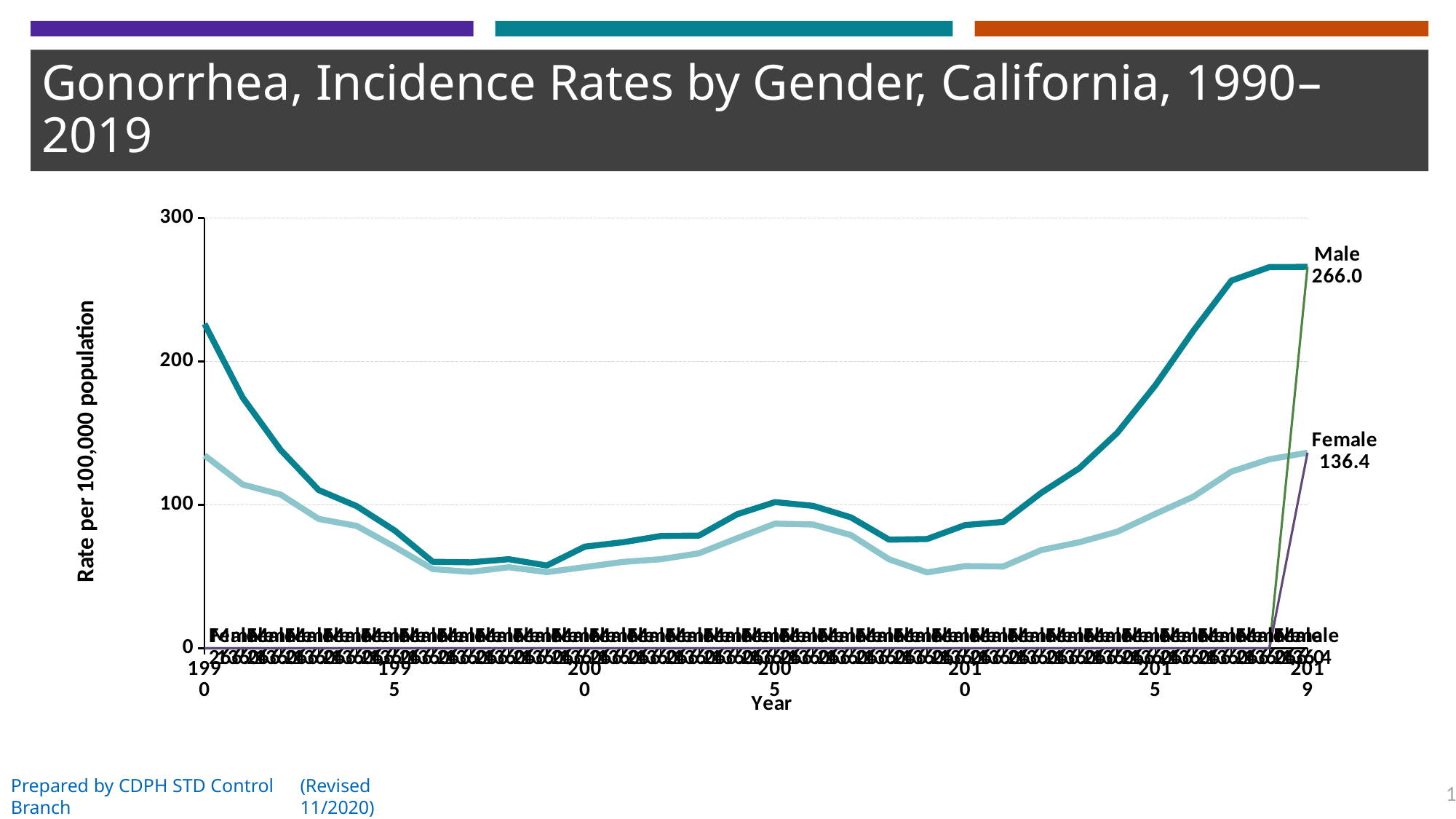
What is the Female gonorrhea incidence rate in 2019? 136.4 What is the Male gonorrhea incidence rate in 2019? 266.0 Does the Male rate rise or fall from 2010 to 2019? rise Is the Female rate in 2005 greater or less than 100? less Is the Female rate in 1990 greater or less than 100? greater What kind of chart is shown on the slide? line chart In 2019, which series has the higher rate, Male or Female? Male Is the Male rate in 2015 greater or less than 200? less How many series are plotted on the chart? 2 What is the label of the vertical axis? Rate per 100,000 population What is the difference between the Male and Female rates in 2019? 129.6